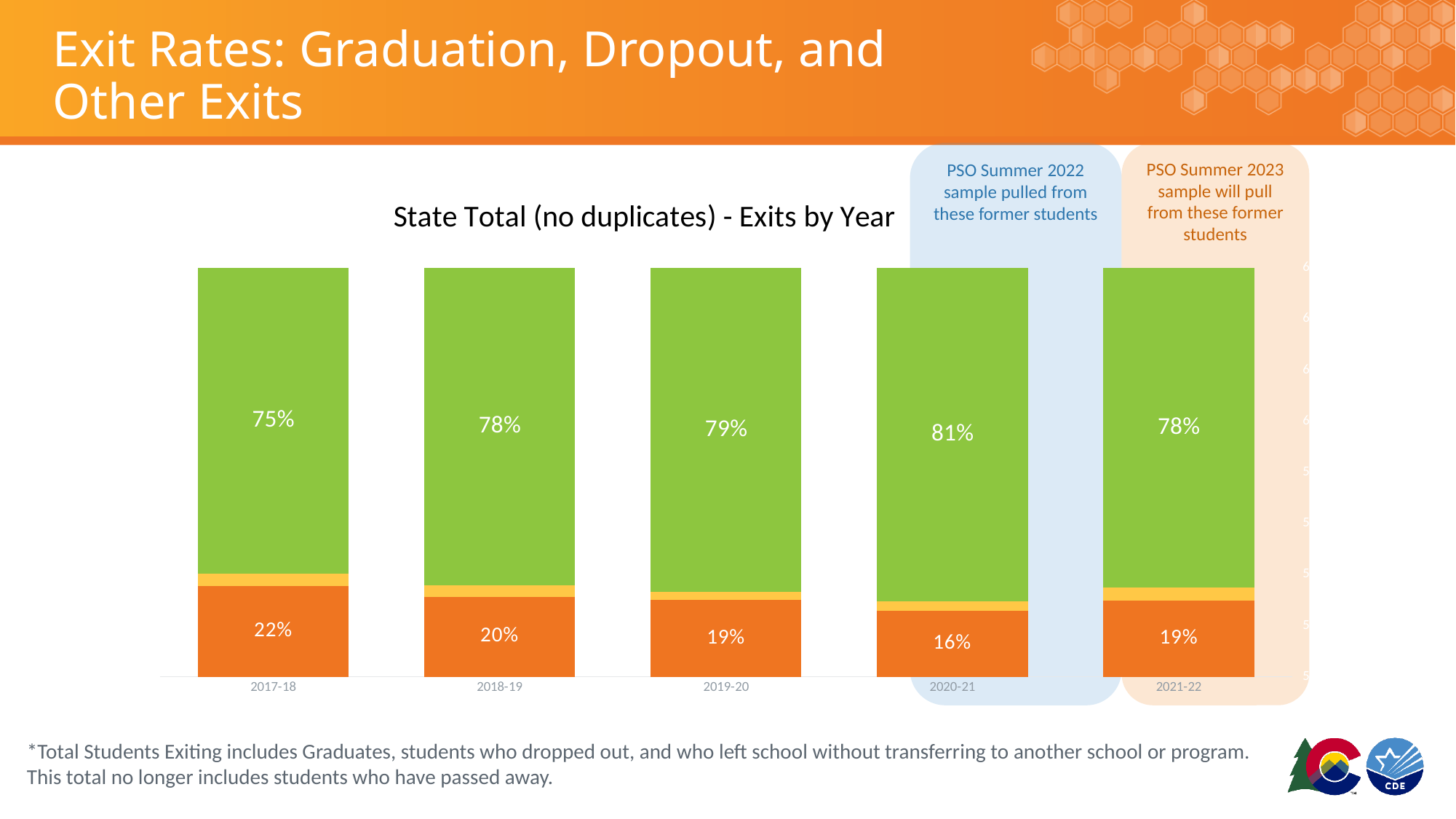
What is the value of the orange segment for 2020-21? 16% Which year has the highest green segment value? 2020-21 Does the orange segment value rise or fall from 2017-18 to 2020-21? Fall What is the value of the green segment for 2021-22? 78% How many years are shown on the x axis? 5 What is the title of the chart? State Total (no duplicates) - Exits by Year What kind of chart is shown on the slide? Stacked bar chart What is the value of the green segment for 2017-18? 75% Which year has the lowest orange segment value? 2020-21 What is the value of the orange segment for 2018-19? 20% Which is larger, the orange segment for 2017-18 or for 2019-20? 2017-18 What is the difference between the green segment values for 2020-21 and 2017-18? 6%